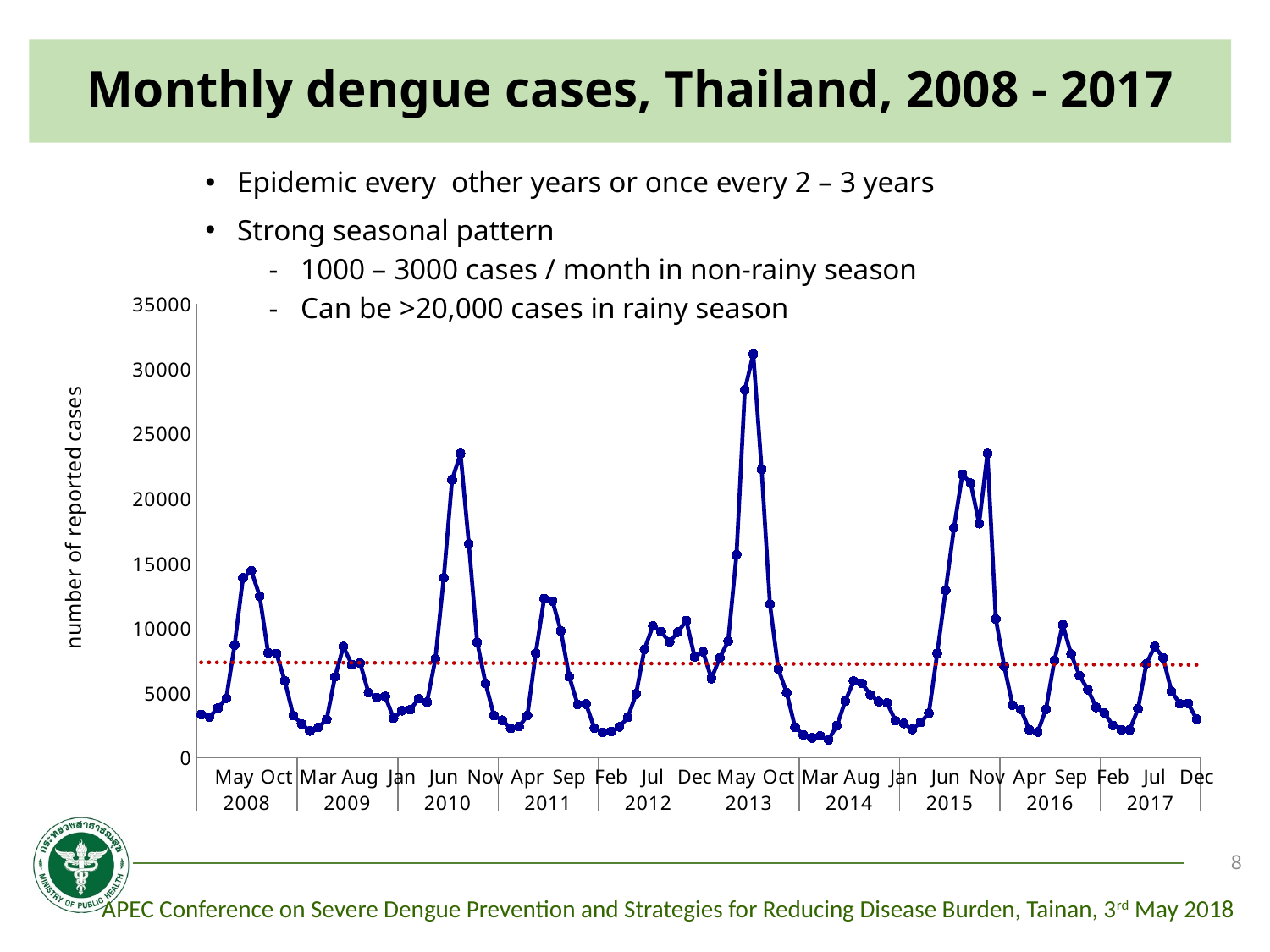
How many years are labelled along the x axis of the chart? 10 In which year does the line reach its highest peak? 2013 Is the peak in 2008 greater or less than 10000 reported cases? greater Is the highest peak in 2013 greater or less than 25000 reported cases? greater What is the label on the vertical axis of the chart? number of reported cases Which year has the higher peak, 2008 or 2014? 2008 What kind of chart is shown on the slide? line chart What is the highest value shown on the vertical axis? 35000 Which year has the higher peak, 2013 or 2010? 2013 Is the peak in 2014 greater or less than 10000 reported cases? less